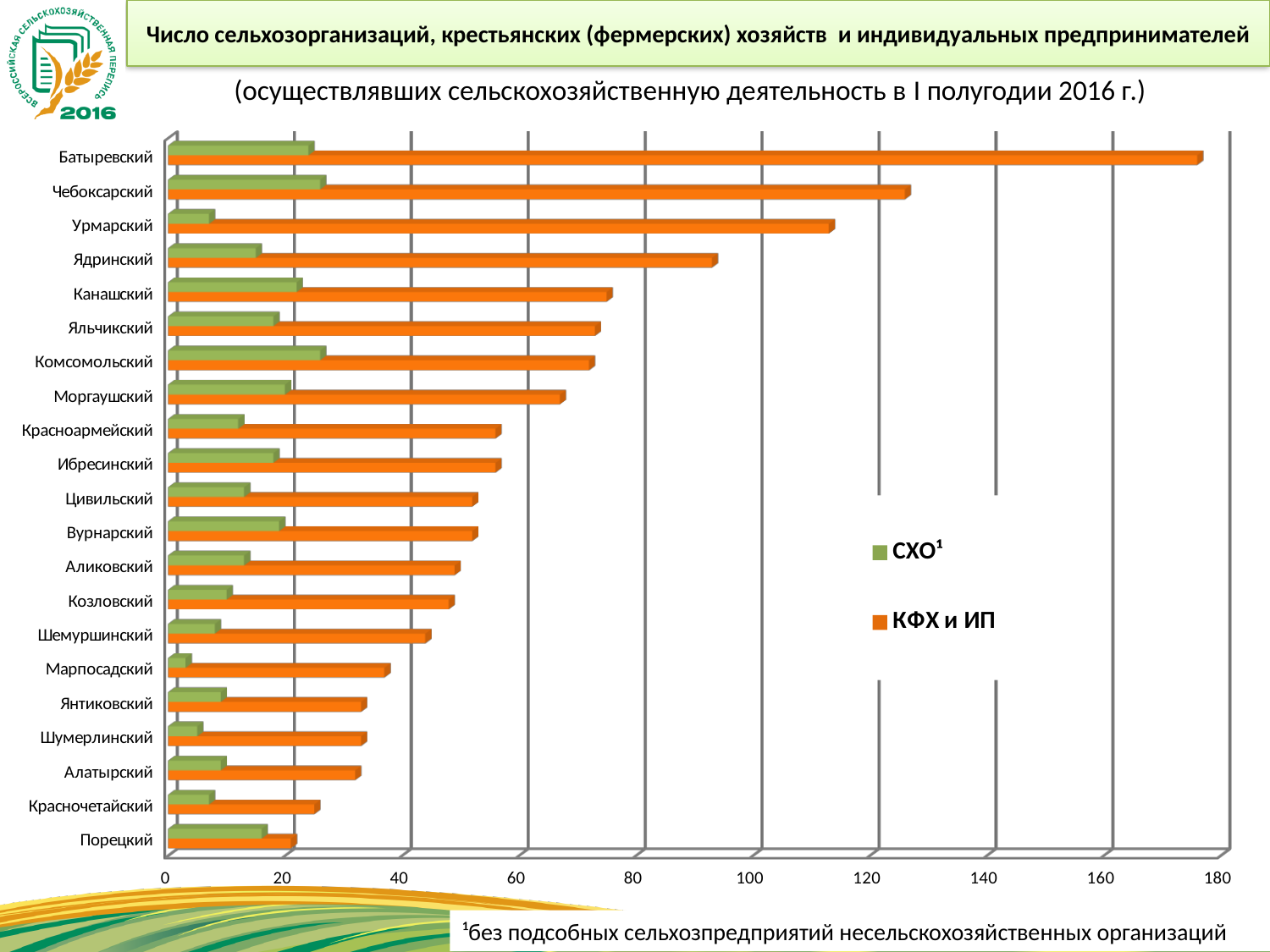
Which district has the lowest value for КФХ и ИП? Порецкий Which is larger: the КФХ и ИП value for Чебоксарский or for Ядринский? Чебоксарский Which district has the highest value for КФХ и ИП? Батыревский Is the СХО¹ value for Марпосадский greater or less than 20? less What colour are the bars for the КФХ и ИП series? orange Which district has the lowest value for СХО¹? Марпосадский Do the КФХ и ИП values increase or decrease going from the top district to the bottom district? decrease Is the КФХ и ИП value for Урмарский greater or less than 120? less How many districts (categories) are plotted on the chart? 21 Is the КФХ и ИП value for Батыревский greater or less than 160? greater What kind of chart is shown on the slide? bar chart How many series does the legend list? 2